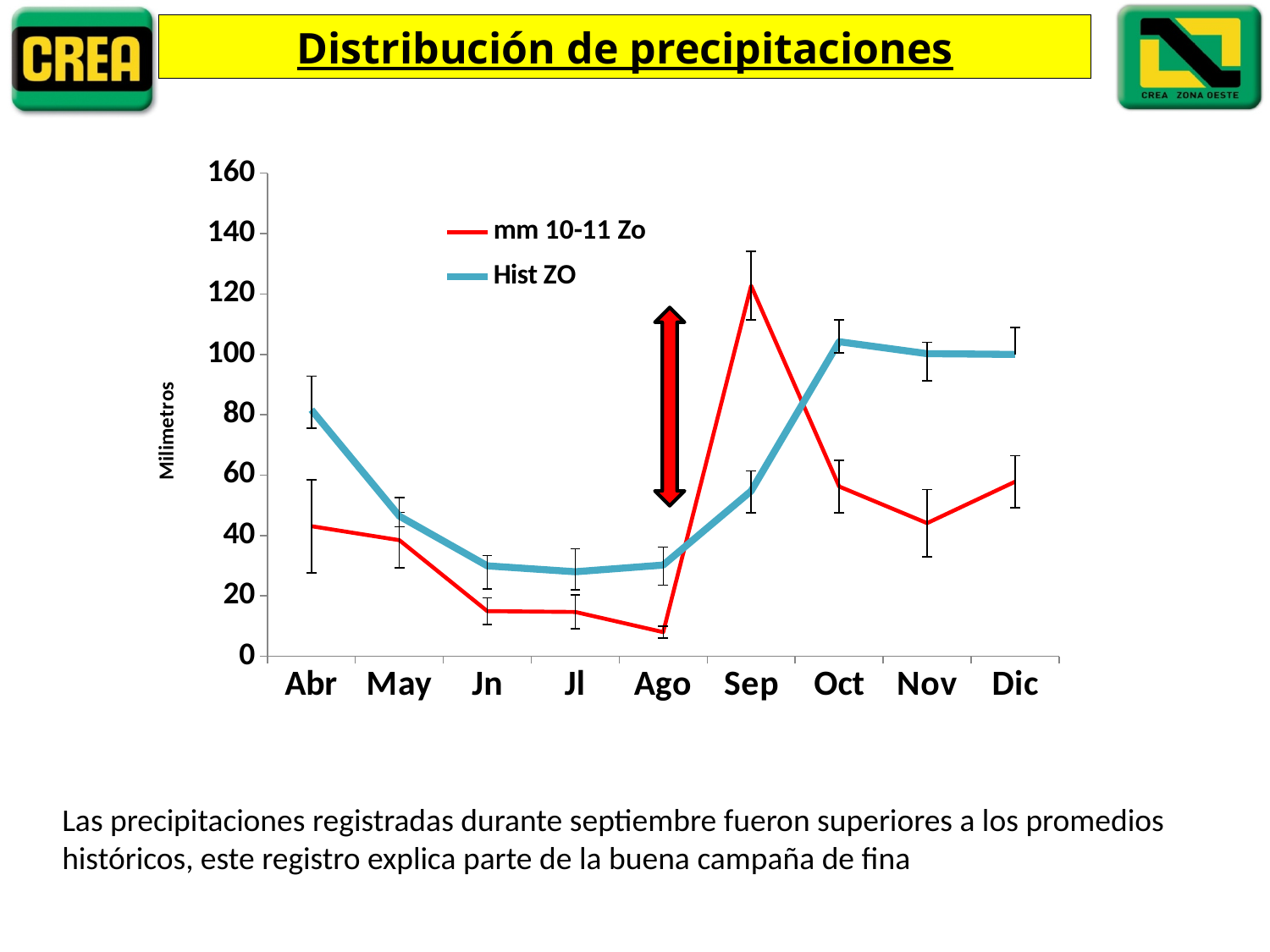
What kind of chart is shown on the slide? line chart Is the mm 10-11 Zo value for Sep greater or less than 100? greater How many series does the legend list? 2 In Oct, which series has the larger value, mm 10-11 Zo or Hist ZO? Hist ZO In which month does the mm 10-11 Zo series reach its highest value? Sep In Sep, which series has the larger value, mm 10-11 Zo or Hist ZO? mm 10-11 Zo Is the Hist ZO value for Abr greater or less than 60? greater Is the mm 10-11 Zo value for Ago greater or less than 20? less In which month does the mm 10-11 Zo series reach its lowest value? Ago What is the label on the vertical axis? Milimetros How many months are shown along the x axis? 9 Does the mm 10-11 Zo series rise or fall from Abr to Ago? fall